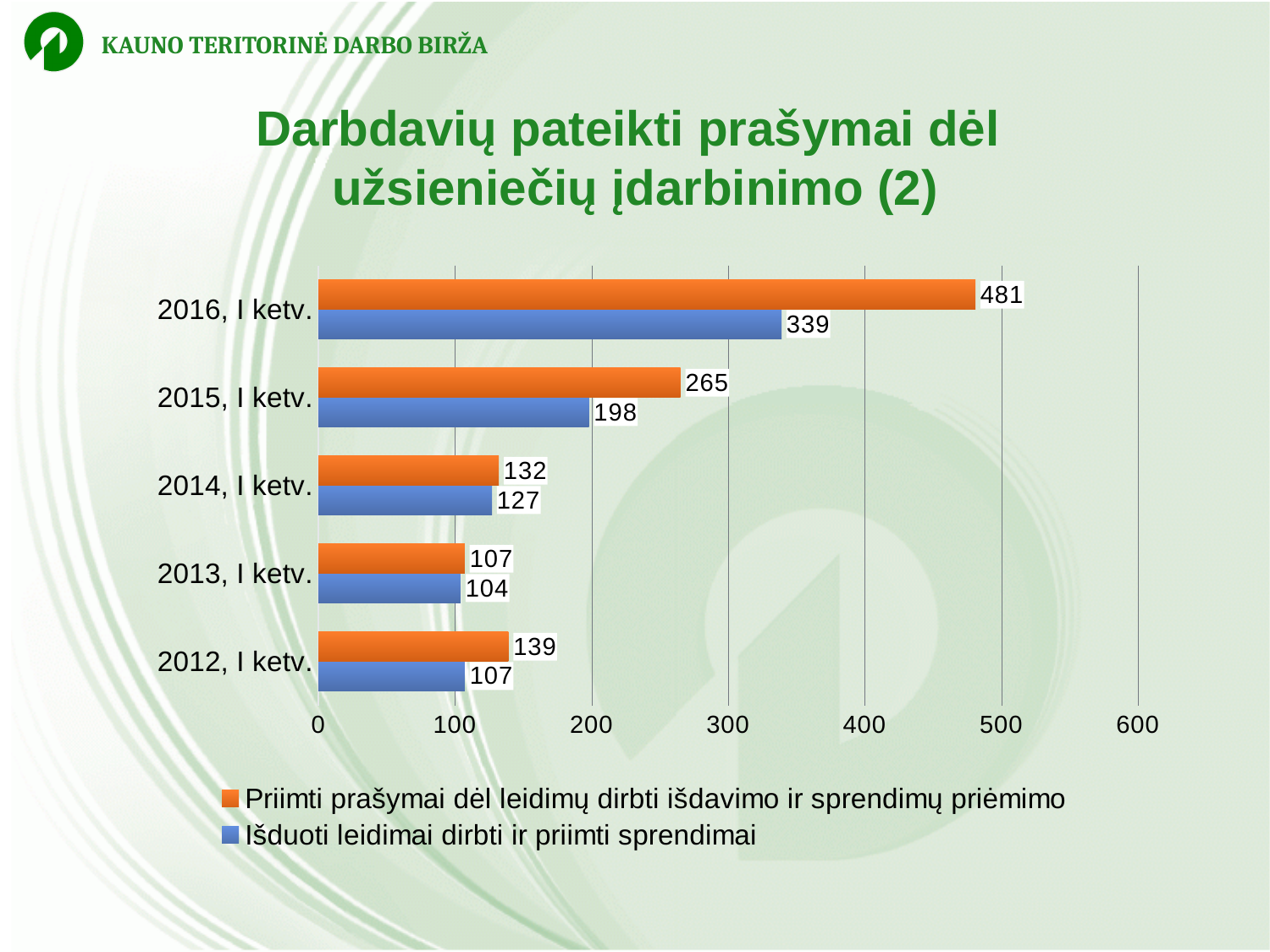
What is the value of 'Išduoti leidimai dirbti ir priimti sprendimai' for 2012, I ketv.? 107 Which period has the lowest value for 'Išduoti leidimai dirbti ir priimti sprendimai'? 2013, I ketv. What is the difference between 'Priimti prašymai dėl leidimų dirbti išdavimo ir sprendimų priėmimo' in 2015, I ketv. and 2014, I ketv.? 133 What kind of chart is shown on the slide? Bar chart How many periods are shown on the chart? 5 What is the value of 'Išduoti leidimai dirbti ir priimti sprendimai' for 2015, I ketv.? 198 Which colour represents 'Išduoti leidimai dirbti ir priimti sprendimai'? Blue How many series does the legend list? 2 What is the value of 'Priimti prašymai dėl leidimų dirbti išdavimo ir sprendimų priėmimo' for 2016, I ketv.? 481 Which is larger: 'Priimti prašymai dėl leidimų dirbti išdavimo ir sprendimų priėmimo' for 2012, I ketv. or for 2013, I ketv.? 2012, I ketv. What is the difference between the two series' values for 2016, I ketv.? 142 Which period has the highest value for 'Priimti prašymai dėl leidimų dirbti išdavimo ir sprendimų priėmimo'? 2016, I ketv.